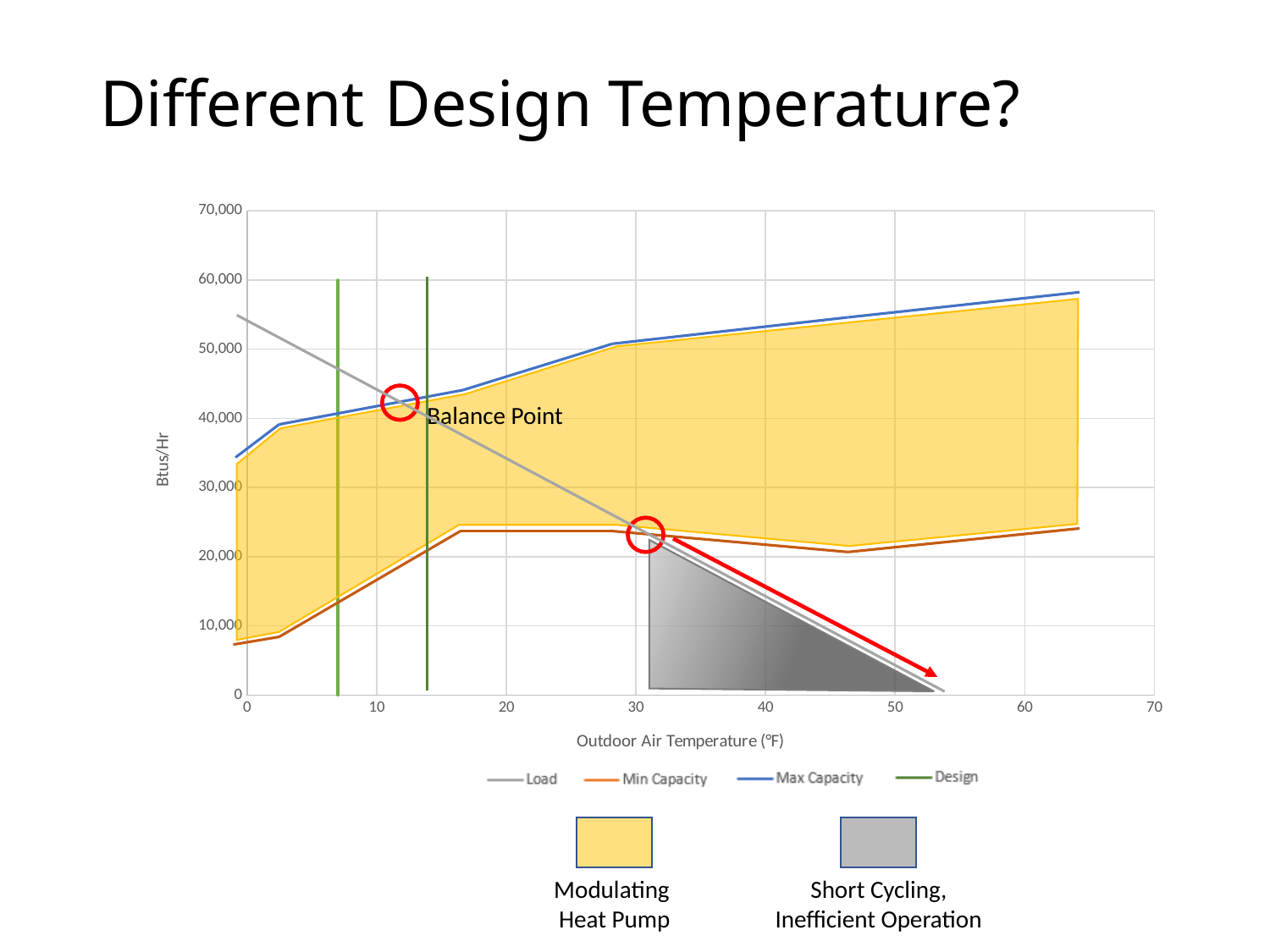
Is the Min Capacity value at 0°F greater or less than 10,000? less What label is written next to the circled intersection of the Load and Max Capacity lines? Balance Point Does the Max Capacity line rise or fall as outdoor air temperature increases? rises What kind of chart is shown on the slide? line chart Does the Load line rise or fall as outdoor air temperature increases? falls Is the Max Capacity value at 60°F greater or less than 50,000? greater Is the Max Capacity value at 0°F greater or less than 30,000? greater At 0°F, which is larger: Load or Max Capacity? Load How many series does the chart legend list? 4 What is the title of the vertical axis? Btus/Hr At 50°F, which is larger: Max Capacity or Load? Max Capacity